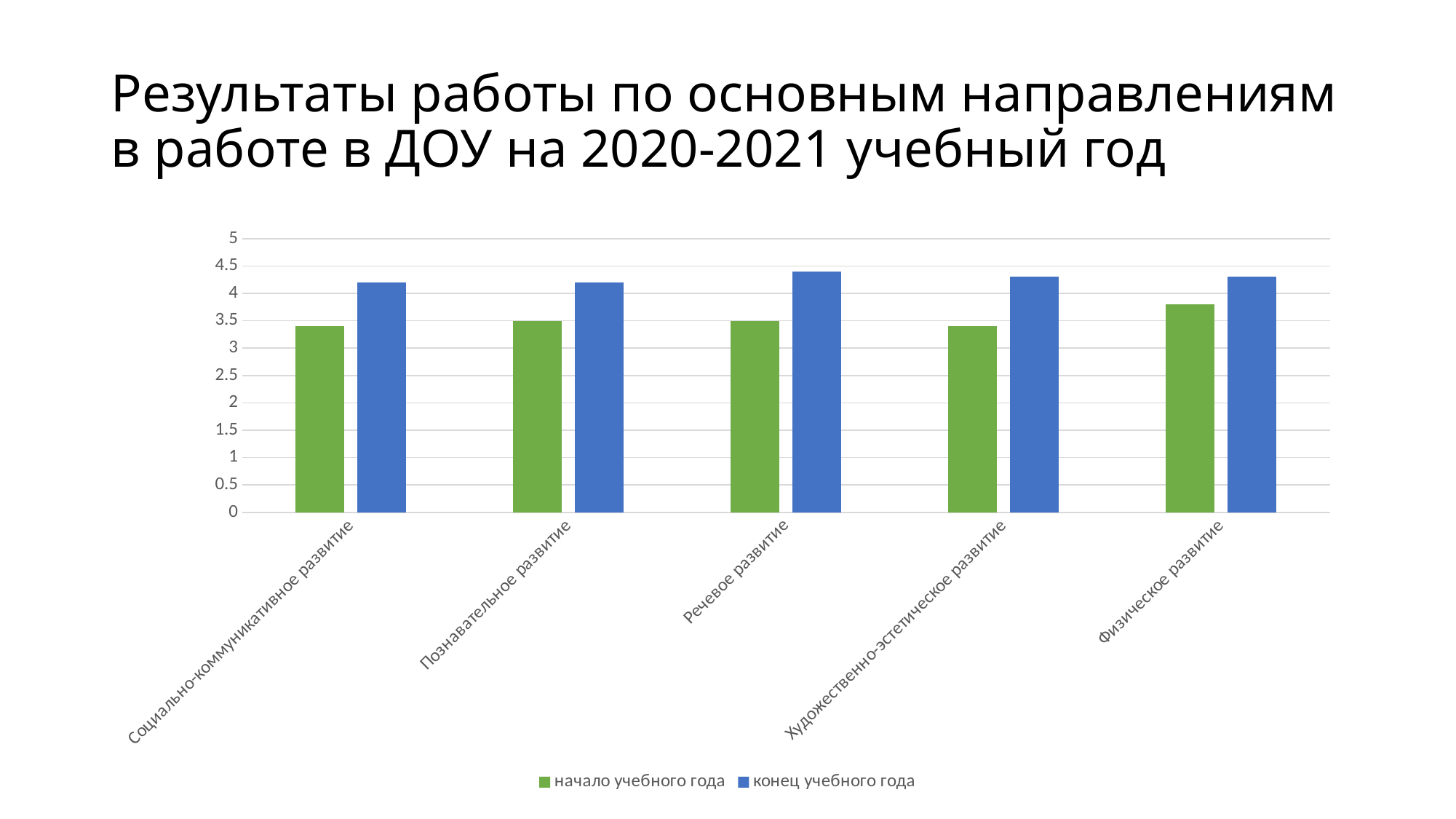
How many series does the chart's legend list? 2 Is the value for конец учебного года in Социально-коммуникативное развитие greater or less than 4? greater Which series is shown in green in the chart? начало учебного года Which series is shown in blue in the chart? конец учебного года Which category has the highest value for начало учебного года? Физическое развитие How many categories are shown on the x axis of the chart? 5 For Речевое развитие, which is larger: начало учебного года or конец учебного года? конец учебного года Is the value for конец учебного года in Речевое развитие greater or less than 4.5? less Is the value for начало учебного года in Физическое развитие greater or less than 3.5? greater For Физическое развитие, which is larger: начало учебного года or конец учебного года? конец учебного года What kind of chart is shown on the slide? bar chart